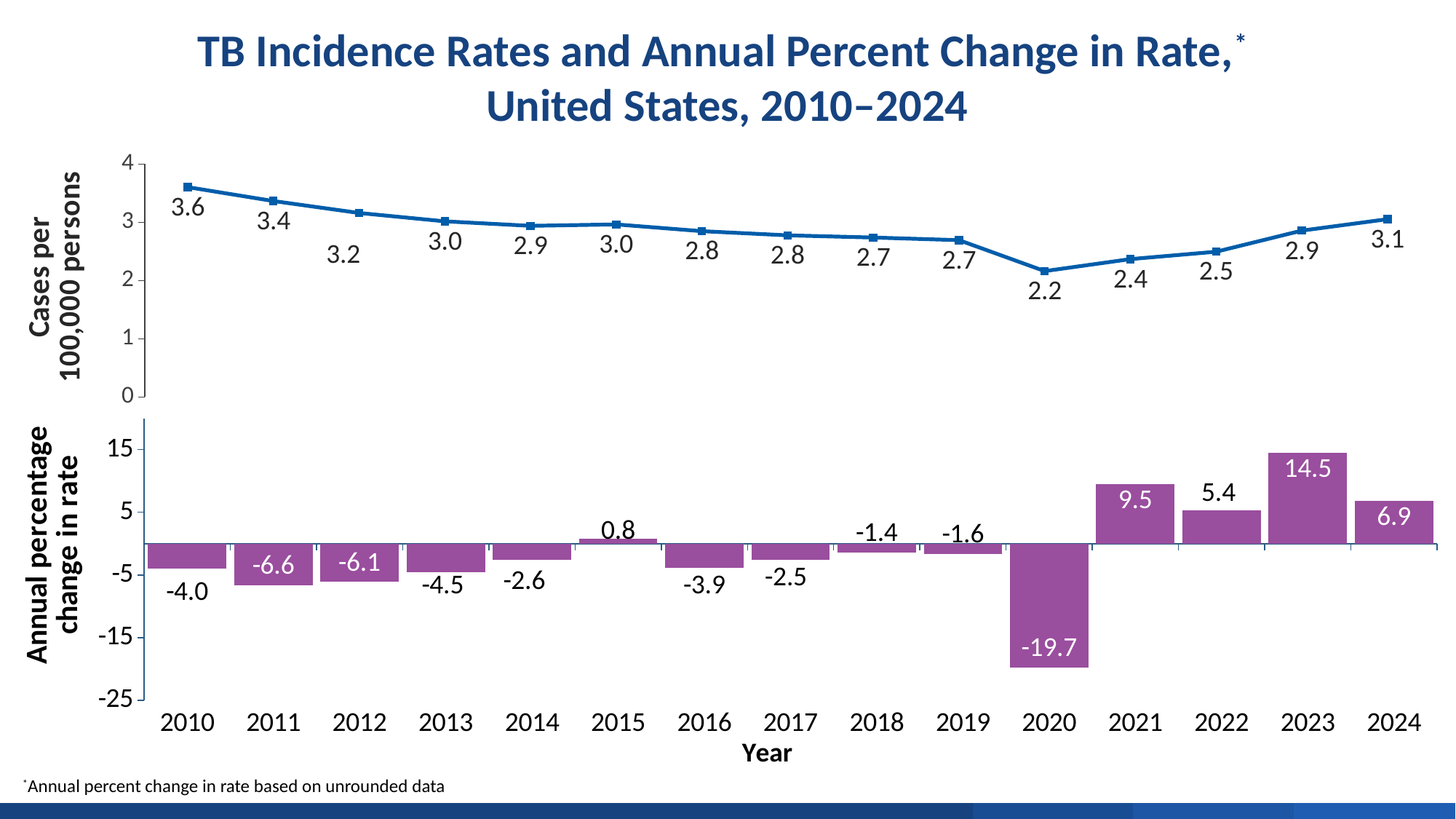
In the bottom chart (annual percentage change in rate), which year has the lowest value? 2020 In the bottom chart (annual percentage change in rate), what kind of chart is shown? bar chart In the top chart (cases per 100,000 persons), what is the TB incidence rate for 2020? 2.2 In the top chart (cases per 100,000 persons), what kind of chart is shown? line chart In the bottom chart (annual percentage change in rate), which is larger, the value for 2021 or the value for 2022? 2021 In the top chart (cases per 100,000 persons), which year has the lowest incidence rate? 2020 In the top chart (cases per 100,000 persons), what is the difference between the 2010 rate and the 2024 rate? 0.5 In the top chart (cases per 100,000 persons), which year has the highest incidence rate? 2010 In the bottom chart (annual percentage change in rate), which year has the highest value? 2023 In the bottom chart (annual percentage change in rate), what is the difference between the 2023 value and the 2024 value? 7.6 In the bottom chart (annual percentage change in rate), what is the value for 2020? -19.7 In the top chart (cases per 100,000 persons), how many years are plotted? 15